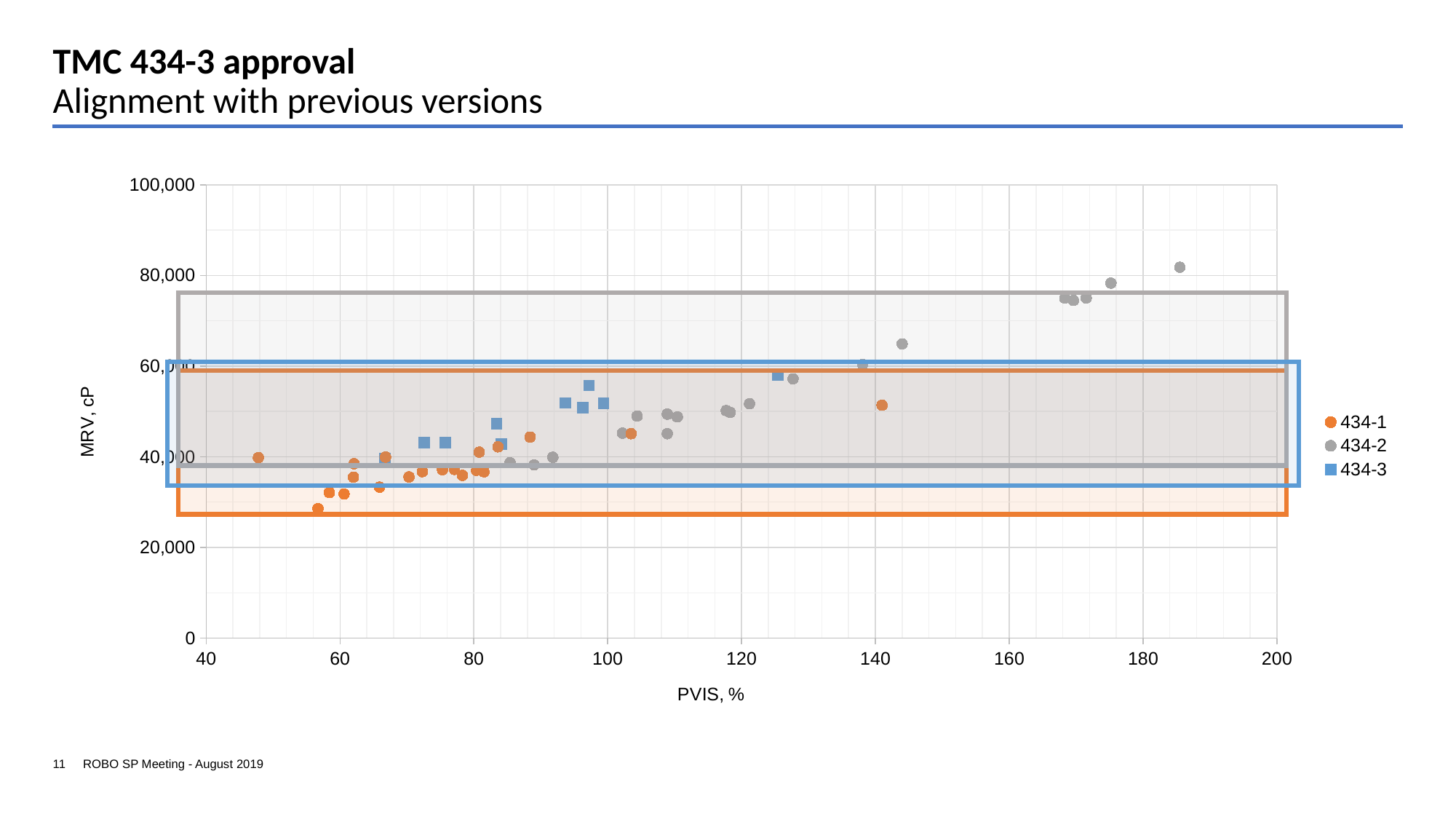
How many series does the chart legend list? 3 Is the MRV value of the highest 434-3 point greater or less than 80,000? less What is the maximum value shown on the vertical axis? 100,000 What kind of chart is shown on the slide? Scatter chart What is the label of the horizontal axis? PVIS, % Which series reaches higher MRV values, 434-2 or 434-3? 434-2 Is the MRV value of the highest 434-2 point greater or less than 80,000? greater Which series contains the point with the lowest MRV value? 434-1 Which series contains the point with the highest MRV value? 434-2 Do the MRV values generally rise or fall as PVIS increases? rise Is the MRV value of the lowest 434-1 point greater or less than 40,000? less What are the three series named in the legend? 434-1, 434-2, 434-3